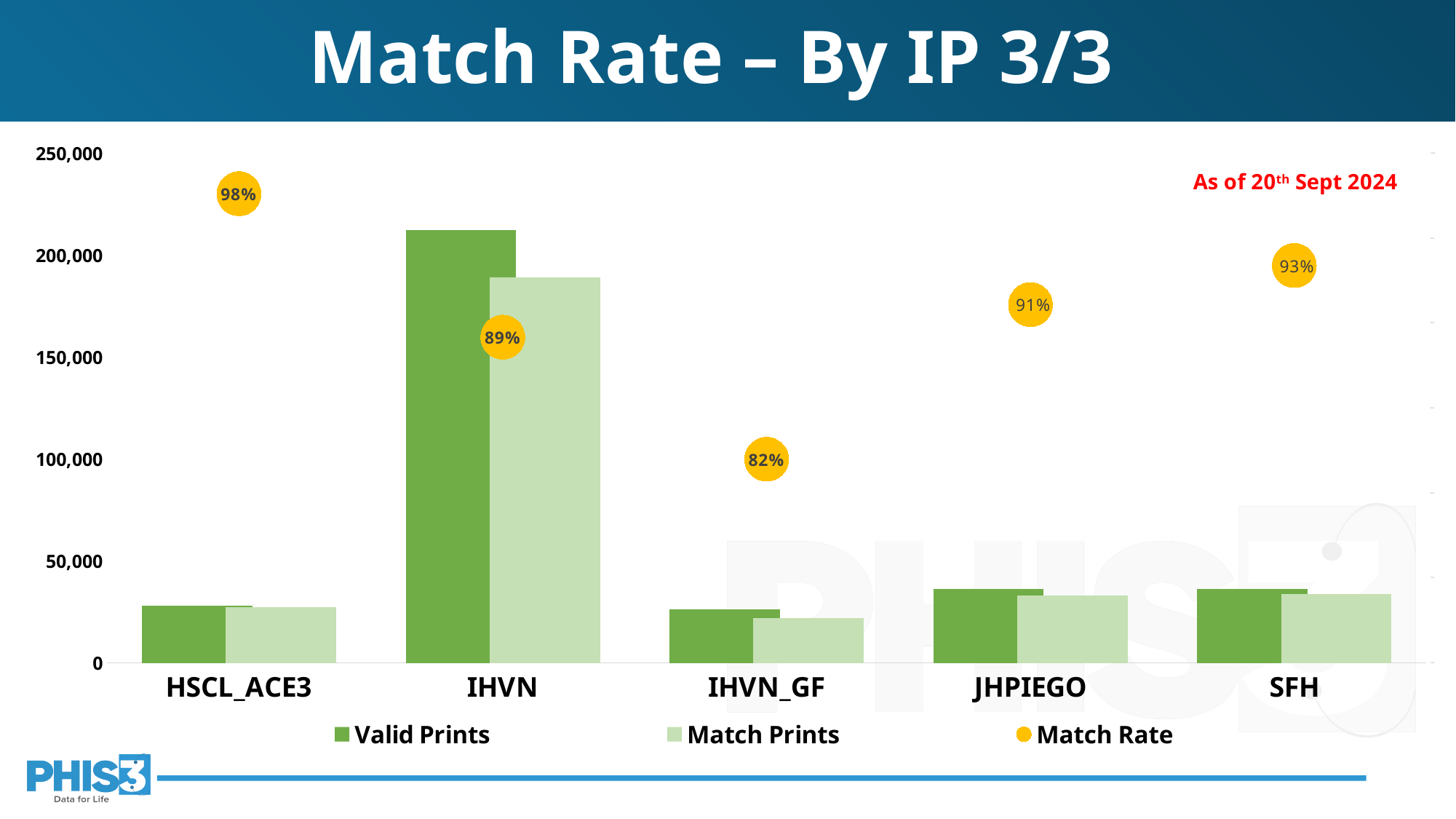
How many IPs are shown on the x axis of the chart? 5 Is the Valid Prints value for IHVN greater or less than 200,000? greater What is the Match Rate for IHVN_GF? 82% Which IP has the lowest Match Rate? IHVN_GF What is the Match Rate for HSCL_ACE3? 98% What is the difference between the Match Rate for HSCL_ACE3 and the Match Rate for IHVN_GF? 16 percentage points Which IP has the highest Match Rate? HSCL_ACE3 Which has the higher Match Rate, JHPIEGO or SFH? SFH Is the Valid Prints value for HSCL_ACE3 greater or less than 50,000? less What is the Match Rate for SFH? 93% Which IP has the highest Valid Prints bar? IHVN How many series does the chart legend list? 3